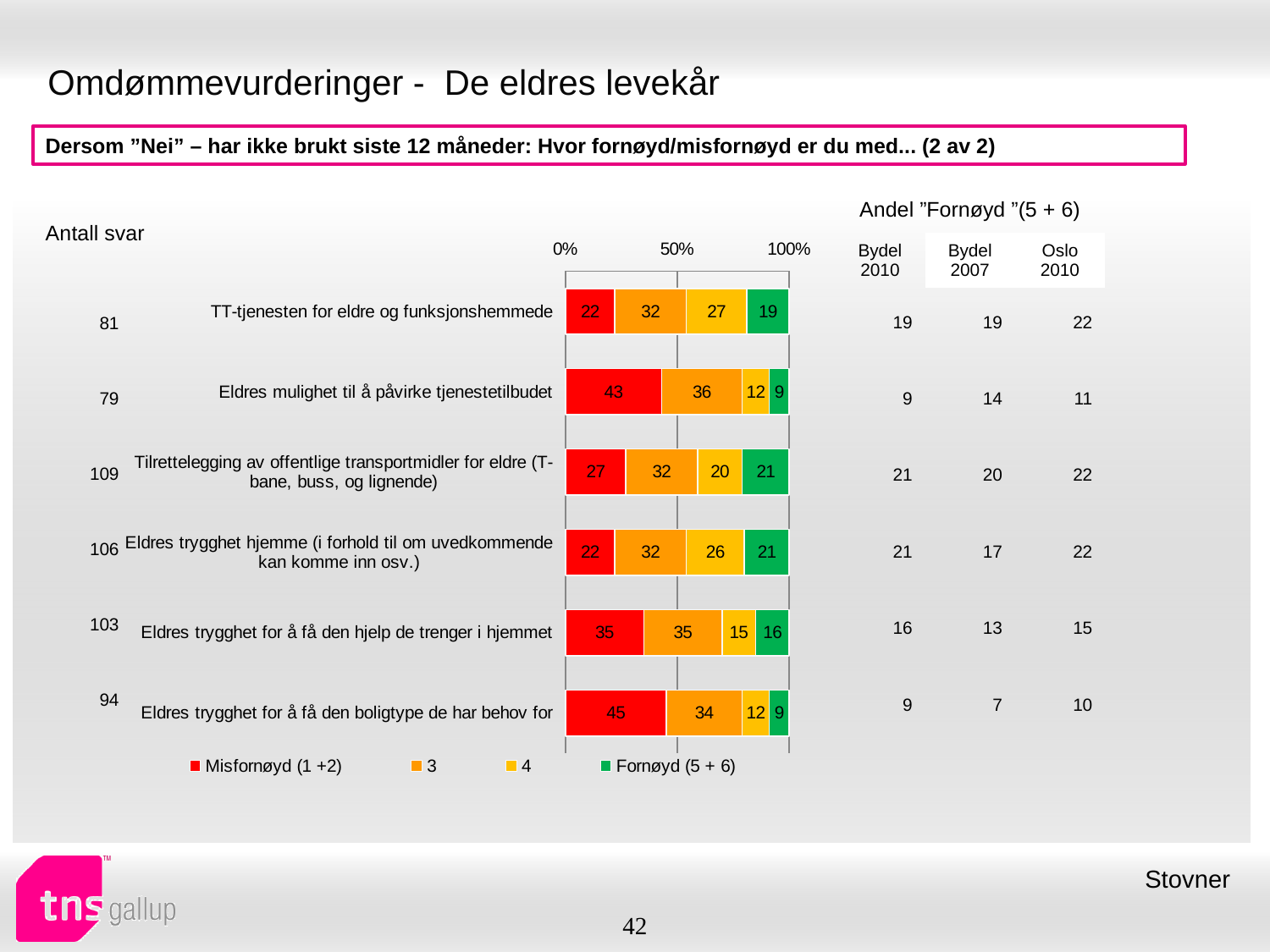
Which category has the highest Misfornøyd (1 +2) value? Eldres trygghet for å få den boligtype de har behov for What kind of chart is shown on the slide? bar chart What is the value of series '3' for 'Eldres mulighet til å påvirke tjenestetilbudet'? 36 What is the difference between the Misfornøyd (1 +2) values for 'Eldres trygghet for å få den boligtype de har behov for' and 'TT-tjenesten for eldre og funksjonshemmede'? 23 What is the Fornøyd (5 + 6) value for 'TT-tjenesten for eldre og funksjonshemmede'? 19 How many categories (statements) are plotted in the chart? 6 Which colour represents the Fornøyd (5 + 6) series in the chart? green How many series does the chart legend list? 4 What is the Misfornøyd (1 +2) value for 'Eldres trygghet for å få den boligtype de har behov for'? 45 Which category has the highest value for series '4'? TT-tjenesten for eldre og funksjonshemmede Which has the larger Misfornøyd (1 +2) value: 'Eldres mulighet til å påvirke tjenestetilbudet' or 'Tilrettelegging av offentlige transportmidler for eldre (T-bane, buss, og lignende)'? Eldres mulighet til å påvirke tjenestetilbudet What is the value of series '4' for 'Eldres trygghet hjemme (i forhold til om uvedkommende kan komme inn osv.)'? 26